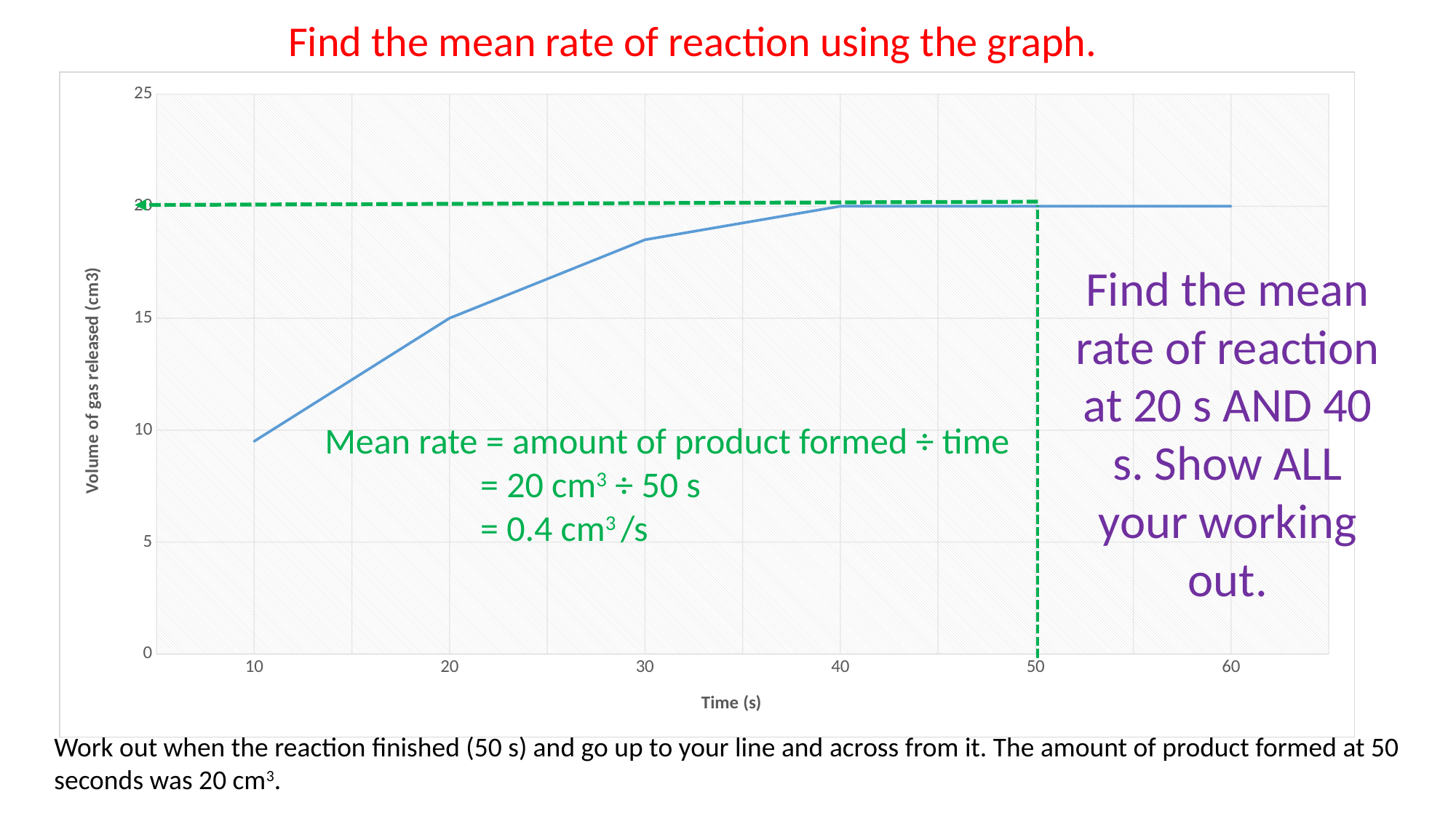
How many time points are plotted on the line? 6 What kind of chart is shown on the slide? line chart At which time is the volume of gas released lowest? 10 s What is the label on the x axis? Time (s) What is the volume of gas released at 60 s? 20 cm3 Which is larger, the volume of gas released at 20 s or at 30 s? 30 s What is the label on the y axis? Volume of gas released (cm3) Is the volume of gas released at 30 s greater or less than 15? greater What is the volume of gas released at 50 s? 20 cm3 Is the volume of gas released at 10 s greater or less than 5? greater Does the volume of gas released rise or fall as time increases from 10 s to 40 s? rise Is the volume of gas released at 10 s greater or less than 10? less